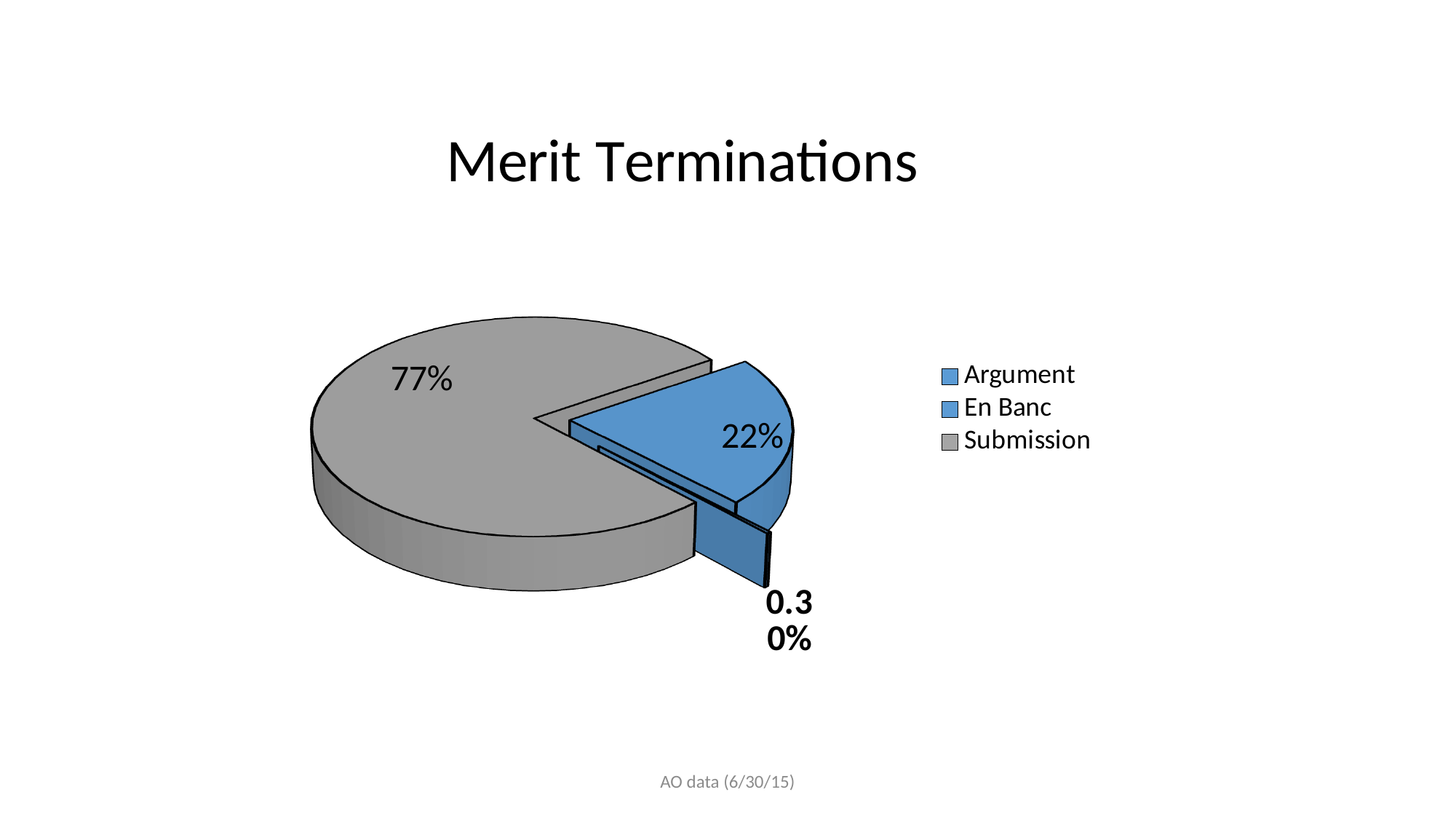
Which category has the largest slice of the pie? Submission What kind of chart is shown on the slide? pie chart How many entries does the legend list? 3 What share of the pie does Submission account for? 77% What is the title of the chart? Merit Terminations How many slices does the pie chart have? 3 Which is larger, the share for Submission or the share for Argument? Submission What percentage is shown for En Banc? 0.30% Which category has the smallest slice of the pie? En Banc What is the difference in percentage points between the Submission share and the Argument share? 55% What colour is the Submission slice in the pie chart? grey What share of the pie does Argument account for? 22%